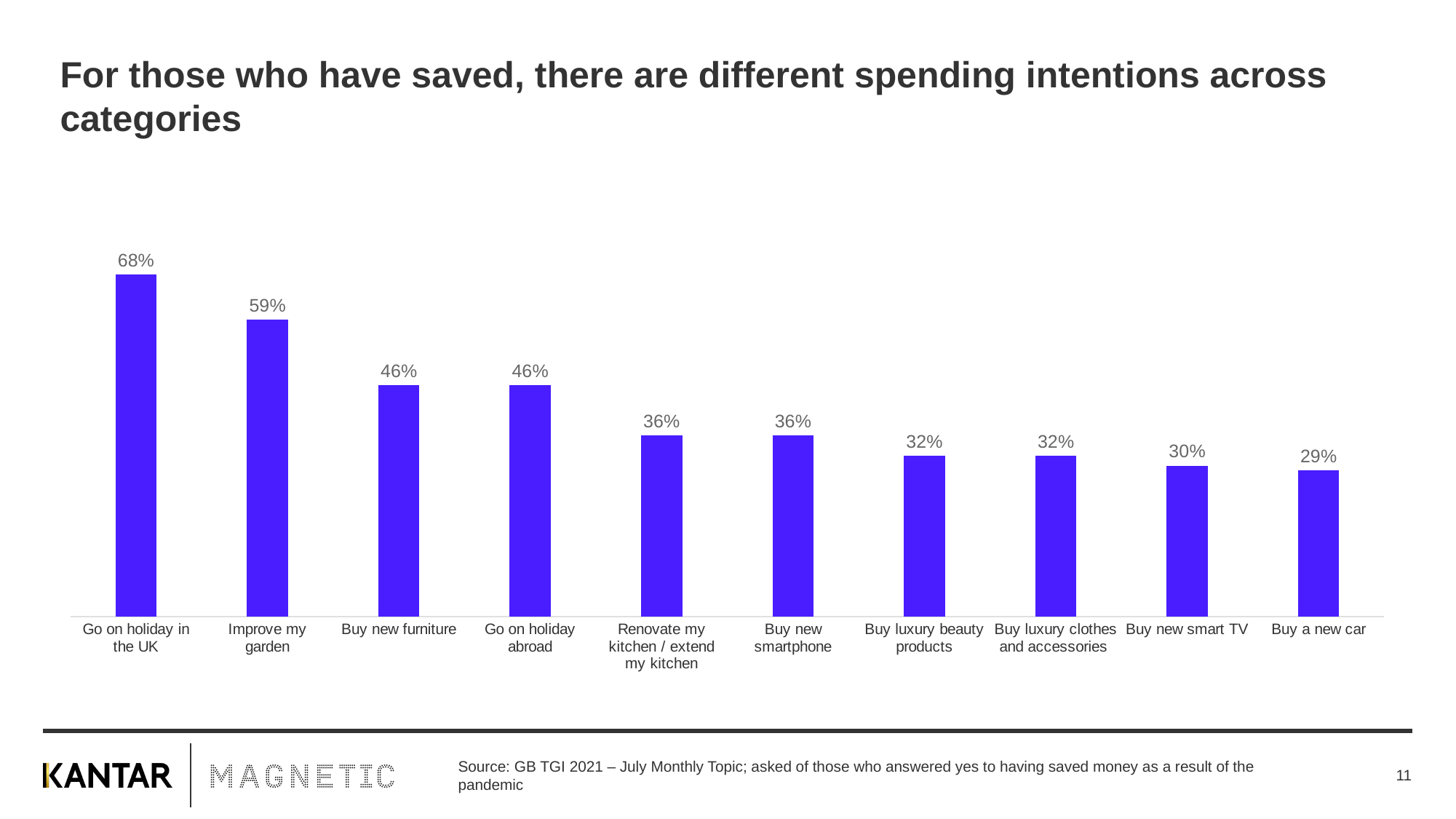
How many categories are shown in the chart? 10 What is the difference between 'Go on holiday in the UK' and 'Improve my garden'? 9 percentage points What is the difference between 'Buy new smart TV' and 'Buy a new car'? 1 percentage point What colour are the bars in the chart? Blue Which category has the lowest value? Buy a new car Which is larger, the value for 'Improve my garden' or the value for 'Buy new furniture'? Improve my garden What percentage of savers intend to go on holiday in the UK? 68% What kind of chart is shown on the slide? Bar chart What is the value for 'Renovate my kitchen / extend my kitchen'? 36% Do the values rise or fall from left to right across the chart? Fall Which category has the highest value? Go on holiday in the UK What is the value for 'Buy a new car'? 29%